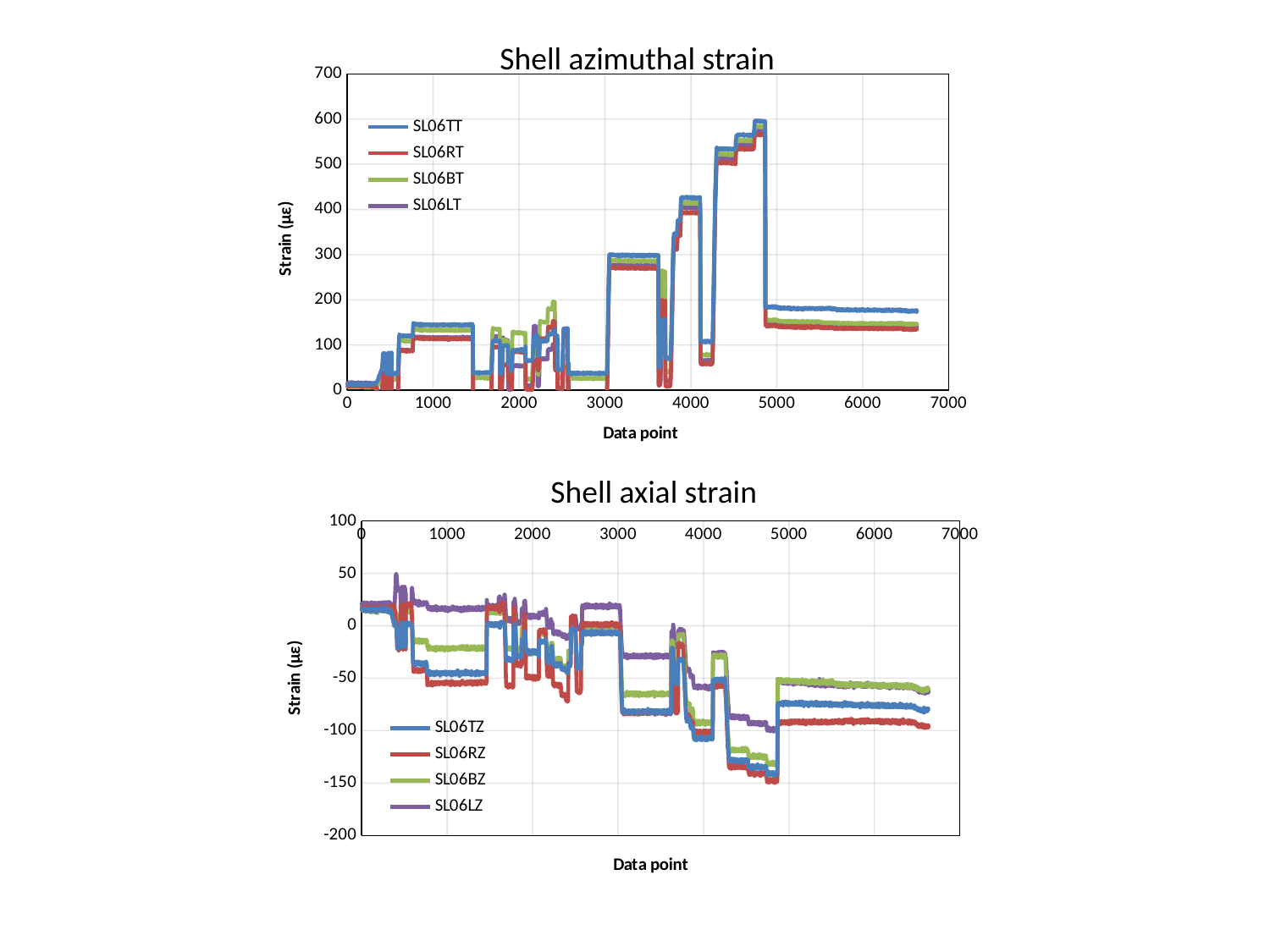
What kind of chart is the "Shell azimuthal strain" chart? line chart In the "Shell axial strain" chart, do the strain values generally rise or fall as the data point increases? fall How many series does the legend of the "Shell axial strain" chart list? 4 In the "Shell axial strain" chart, which series has the larger value at data point 6000, SL06BZ or SL06RZ? SL06BZ What kind of chart is the "Shell axial strain" chart? line chart How many series does the legend of the "Shell azimuthal strain" chart list? 4 In the "Shell azimuthal strain" chart, is the value of SL06TT at data point 6000 greater or less than 100? greater What is the label of the x axis on the "Shell axial strain" chart? Data point In the "Shell axial strain" chart, is the value of SL06BZ at data point 6000 greater or less than -100? greater In the "Shell axial strain" chart, is the value of SL06RZ at data point 6000 greater or less than -50? less In the "Shell azimuthal strain" chart, which series has the larger value at data point 6000, SL06TT or SL06RT? SL06TT